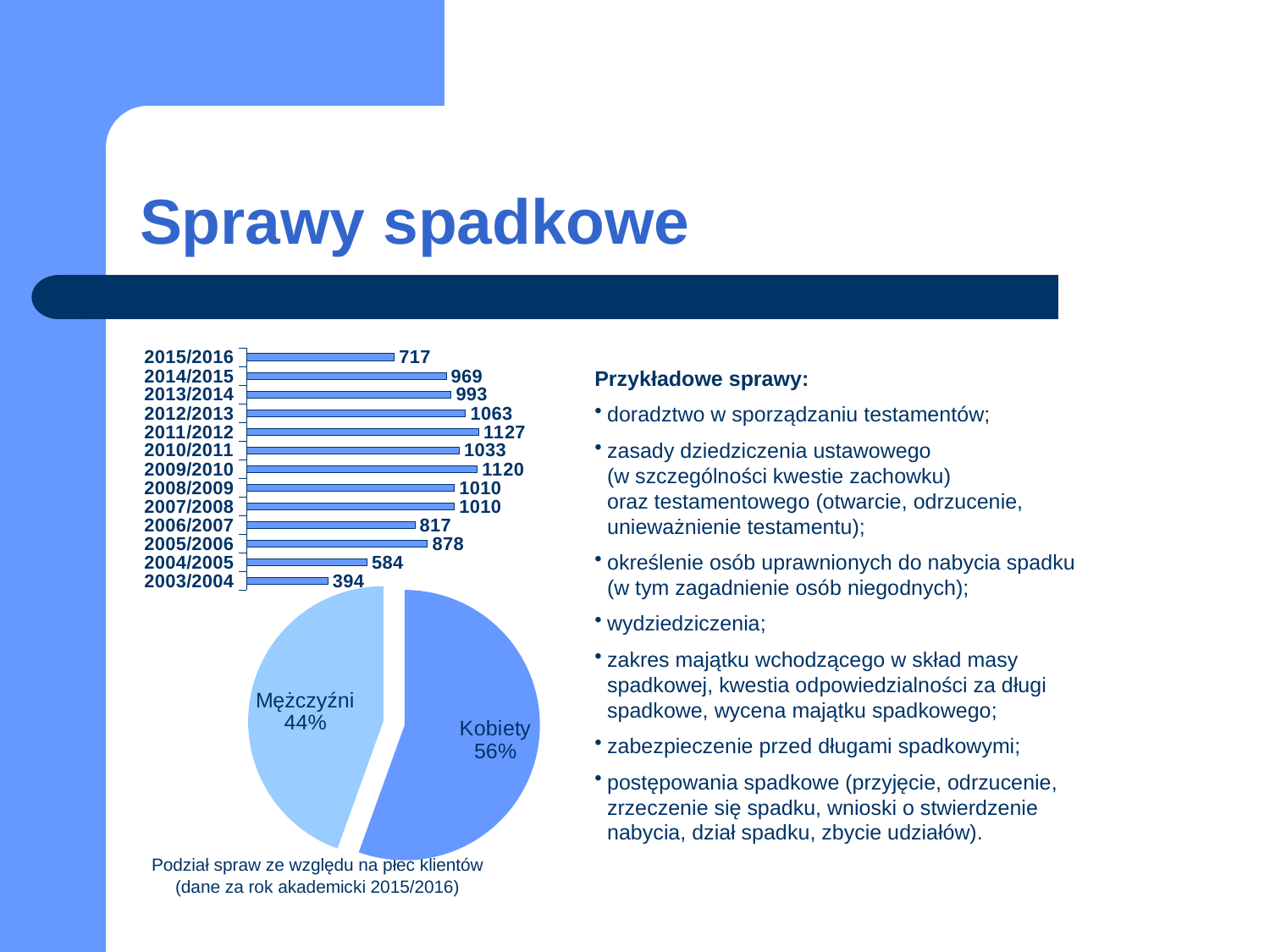
In the bar chart, what is the difference between the values for 2011/2012 and 2015/2016? 410 In the bar chart, which is larger, the value for 2012/2013 or the value for 2010/2011? 2012/2013 In the pie chart, which slice is larger, Kobiety or Mężczyźni? Kobiety In the bar chart, what is the value for 2015/2016? 717 In the pie chart, what share do Mężczyźni have? 44% In the pie chart, what share do Kobiety have? 56% How many years are shown in the bar chart? 13 What kind of chart is the chart at the bottom left of the slide? pie chart In the bar chart, which year has the lowest value? 2003/2004 In the bar chart, what is the value for 2009/2010? 1120 What kind of chart is the chart at the top left of the slide? bar chart In the bar chart, which year has the highest value? 2011/2012